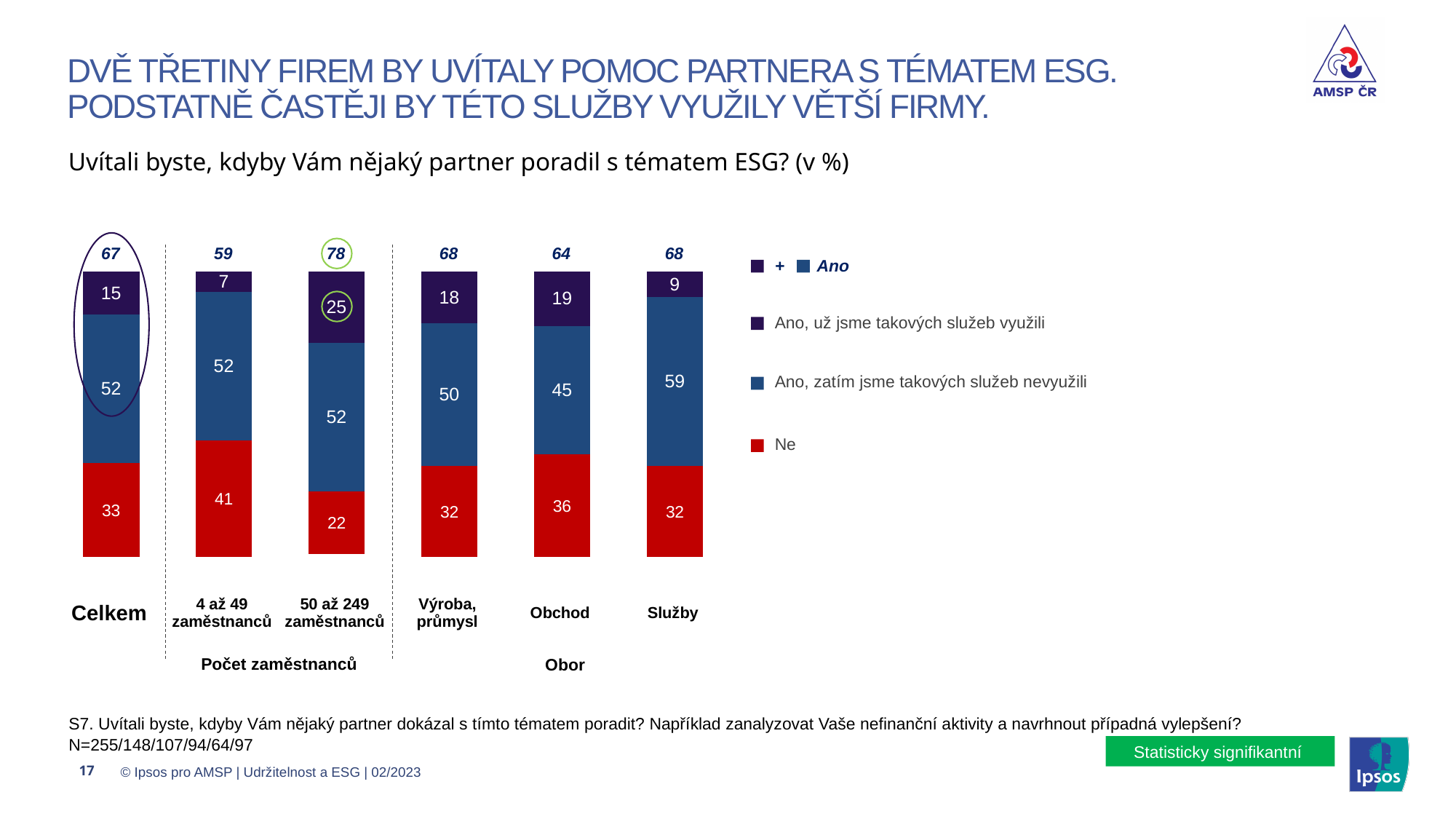
Which category has the lowest value for "Ano, už jsme takových služeb využili"? 4 až 49 zaměstnanců What is the difference between the "Ne" values for 4 až 49 zaměstnanců and 50 až 249 zaměstnanců? 19 How many response series does the legend list below the "Ano" total? 3 Which colour represents "Ne" in the chart? Red Which is larger: the "Ne" value for Obchod or for Výroba, průmysl? Obchod What is the combined "Ano" total shown above the 4 až 49 zaměstnanců bar? 59 What is the value for "Ano, už jsme takových služeb využili" in the 50 až 249 zaměstnanců bar? 25 Which category has the highest combined "Ano" total? 50 až 249 zaměstnanců What is the value for "Ano, zatím jsme takových služeb nevyužili" in the Služby bar? 59 What is the value for "Ne" in the Celkem bar? 33 What kind of chart is shown on the slide? Stacked bar chart How many categories (bars) are shown in the chart? 6